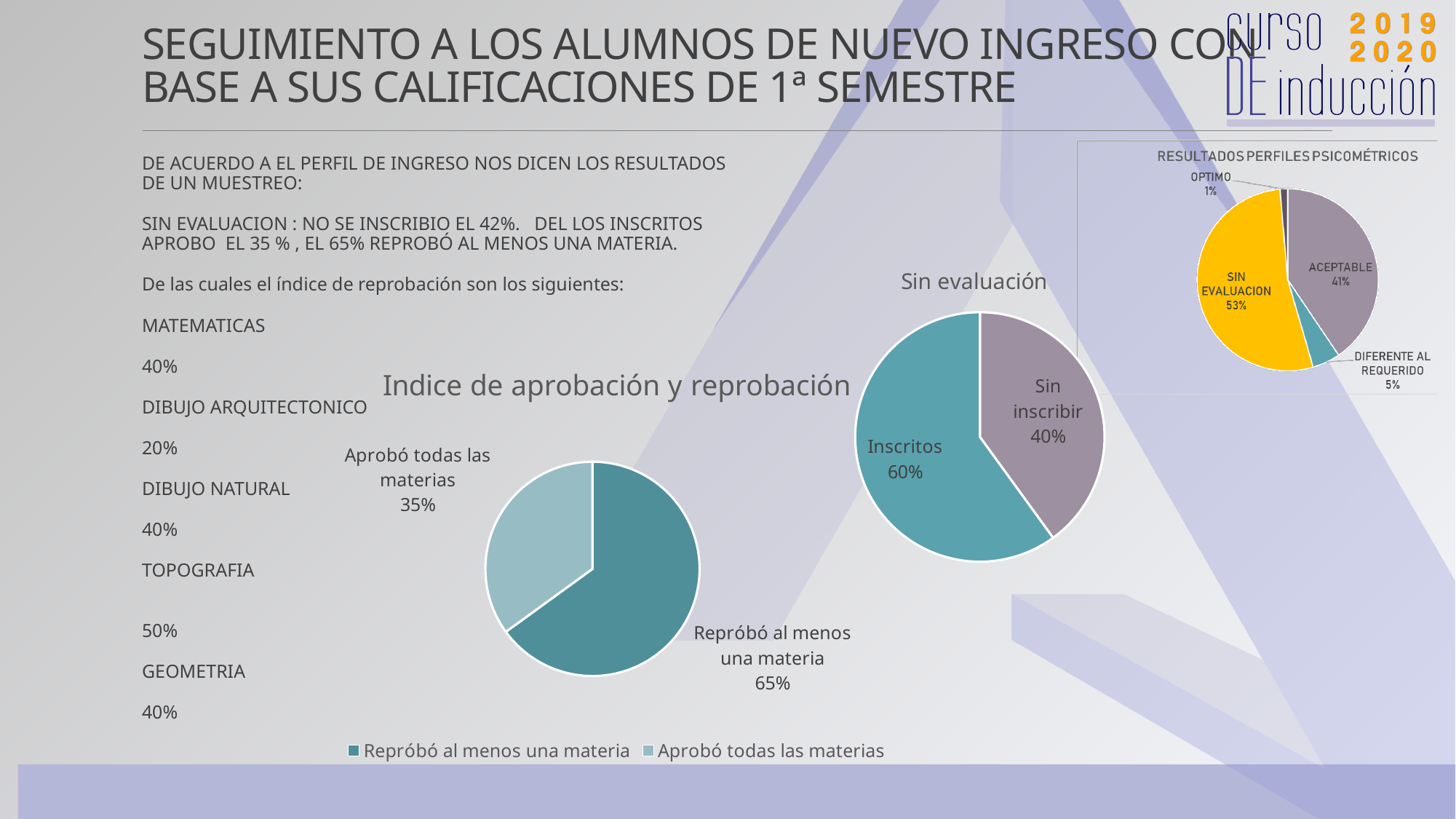
In the 'Sin evaluación' chart, what share is labelled 'Sin inscribir'? 40% In the 'Indice de aprobación y reprobación' chart, which slice is larger: 'Repróbó al menos una materia' or 'Aprobó todas las materias'? Repróbó al menos una materia How many slices does the 'RESULTADOS PERFILES PSICOMÉTRICOS' pie chart have? 4 What kind of chart is 'Indice de aprobación y reprobación'? Pie chart In the 'Sin evaluación' chart, which slice is the largest? Inscritos In the 'Sin evaluación' chart, what share is labelled 'Inscritos'? 60% How many entries does the legend of the 'Indice de aprobación y reprobación' chart list? 2 In the 'Indice de aprobación y reprobación' chart, what share is labelled 'Aprobó todas las materias'? 35% In the 'RESULTADOS PERFILES PSICOMÉTRICOS' chart, what share is labelled 'SIN EVALUACION'? 53% In the 'Indice de aprobación y reprobación' chart, what share is labelled 'Repróbó al menos una materia'? 65% In the 'RESULTADOS PERFILES PSICOMÉTRICOS' chart, which slice is the smallest? OPTIMO In the 'Indice de aprobación y reprobación' chart, what is the difference between the 'Repróbó al menos una materia' and 'Aprobó todas las materias' shares? 30%